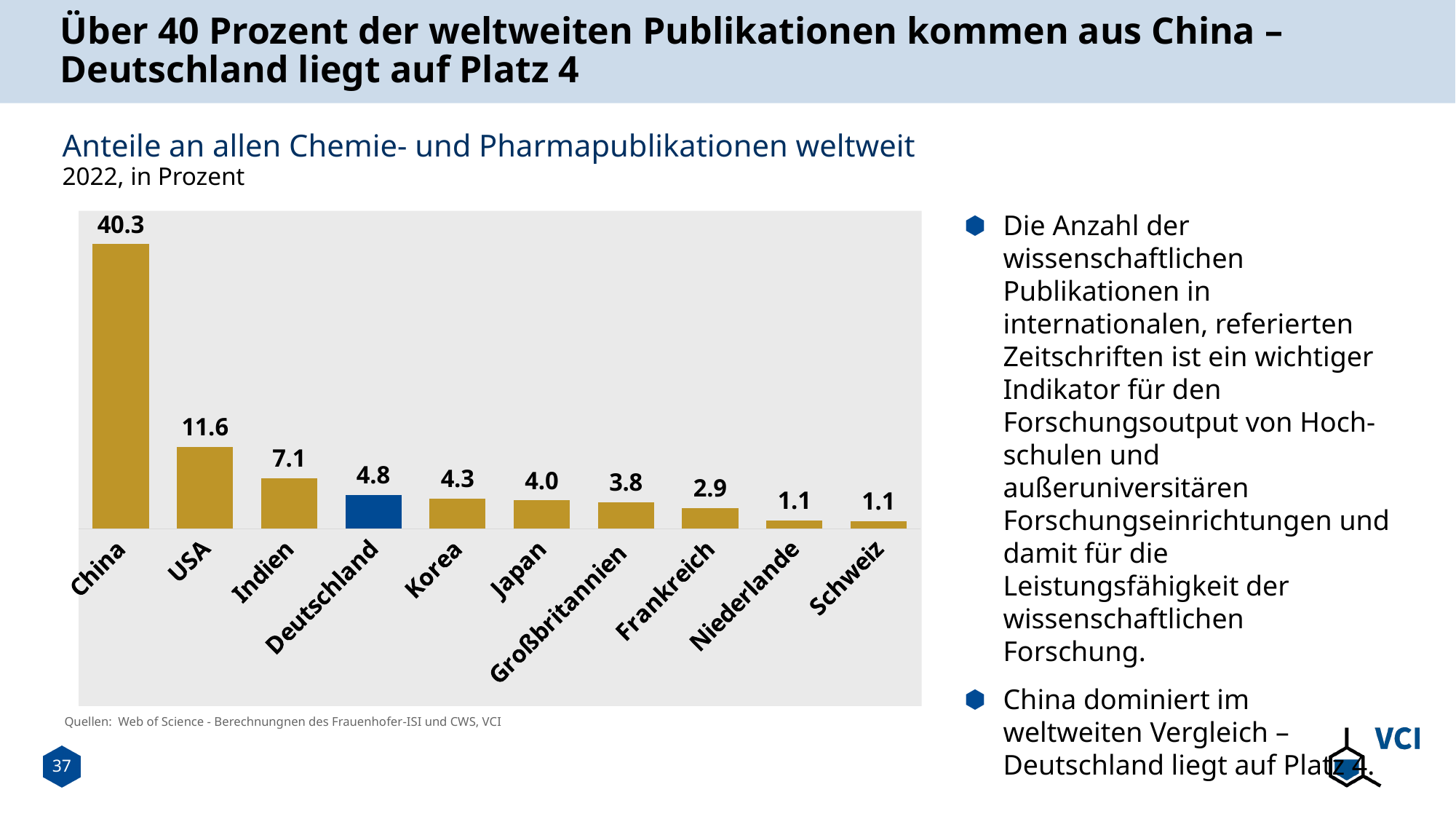
Which is larger, the value for Frankreich or the value for Großbritannien? Großbritannien What is the value for China? 40.3 What is the difference between the values for China and USA? 28.7 What is the value for Deutschland? 4.8 How many countries are shown in the chart? 10 What kind of chart is shown on the slide? Bar chart What is the value for Großbritannien? 3.8 Which country has the highest share? China Do the values rise or fall from left to right along the x axis? Fall Which is larger, the value for Indien or the value for Japan? Indien Which country's bar is shown in a different colour (blue) from the others? Deutschland What is the difference between the values for Deutschland and Korea? 0.5